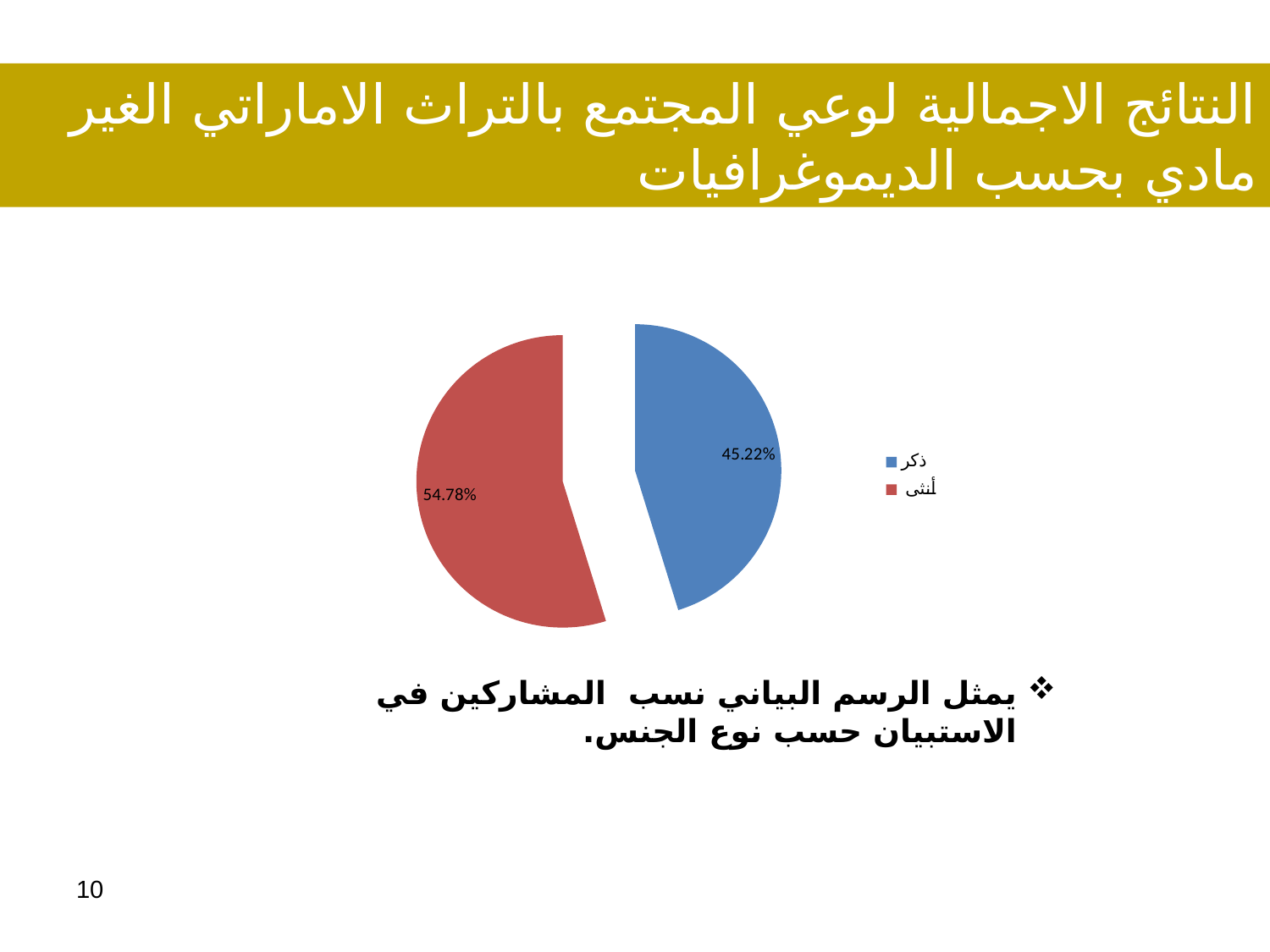
What kind of chart is shown on the slide? pie chart What colour is the slice for ذكر? blue What is the difference in percentage points between the أنثى slice and the ذكر slice? 9.56 Which category has the largest slice of the pie? أنثى What percentage of the pie is labelled for أنثى? 54.78% Which category has the smallest slice of the pie? ذكر What is the share of the pie taken by the أنثى slice? 54.78% What colour is the slice for أنثى? red Which is larger, the slice for ذكر or the slice for أنثى? أنثى What percentage of the pie is labelled for ذكر? 45.22% How many entries does the legend list? 2 How many slices does the pie chart have? 2